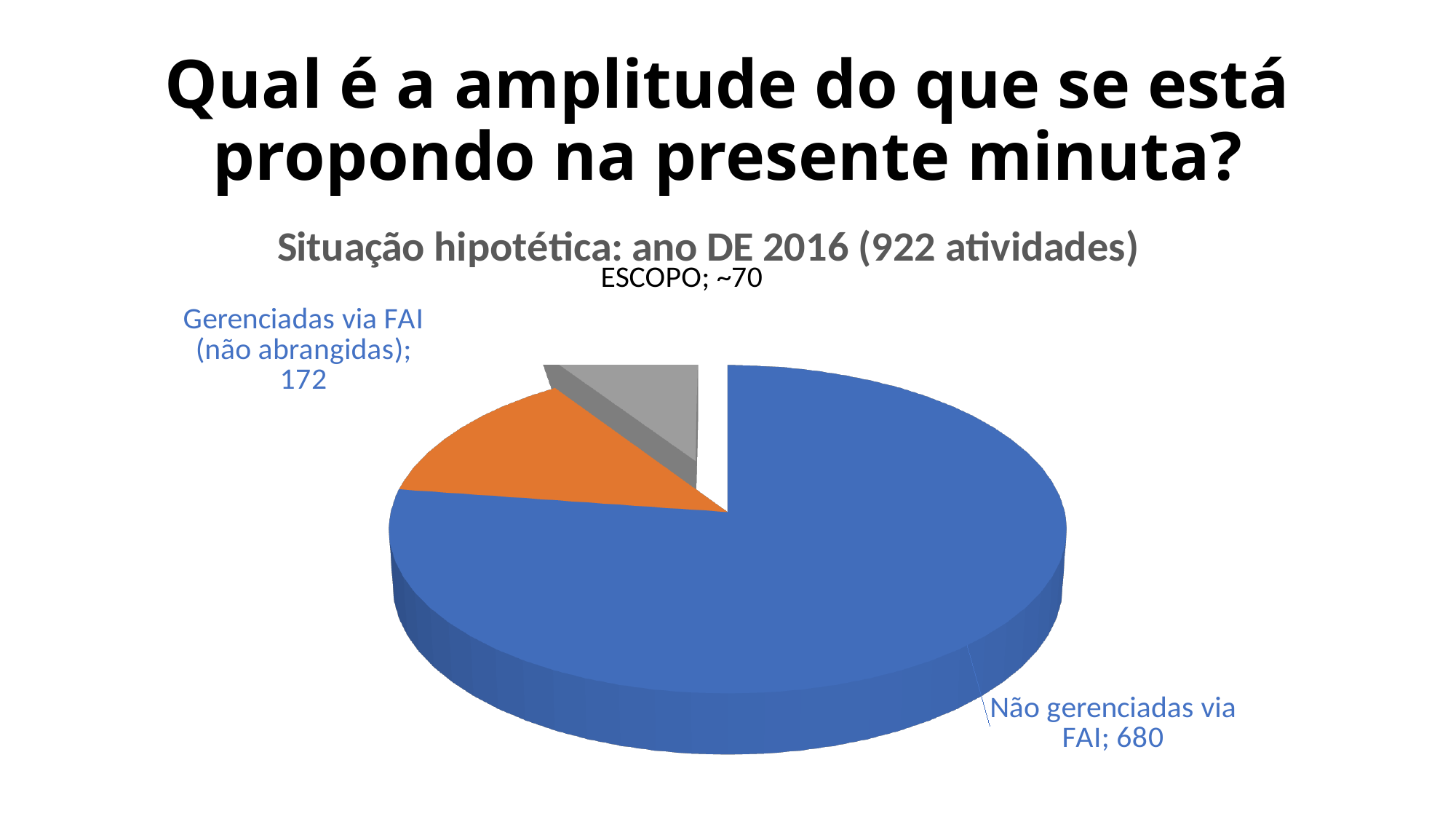
How many slices does the pie chart have? 3 What is the title of the pie chart? Situação hipotética: ano DE 2016 (922 atividades) Which slice of the pie chart is the largest? Não gerenciadas via FAI What is the value for "Não gerenciadas via FAI"? 680 What is the value for "Gerenciadas via FAI (não abrangidas)"? 172 What colour is the largest slice of the pie chart? blue Which is larger: "Gerenciadas via FAI (não abrangidas)" or "ESCOPO"? Gerenciadas via FAI (não abrangidas) What is the difference between the values for "Não gerenciadas via FAI" and "Gerenciadas via FAI (não abrangidas)"? 508 Which slice of the pie chart is the smallest? ESCOPO Which is larger: "Não gerenciadas via FAI" or "Gerenciadas via FAI (não abrangidas)"? Não gerenciadas via FAI What kind of chart is shown on the slide? pie chart